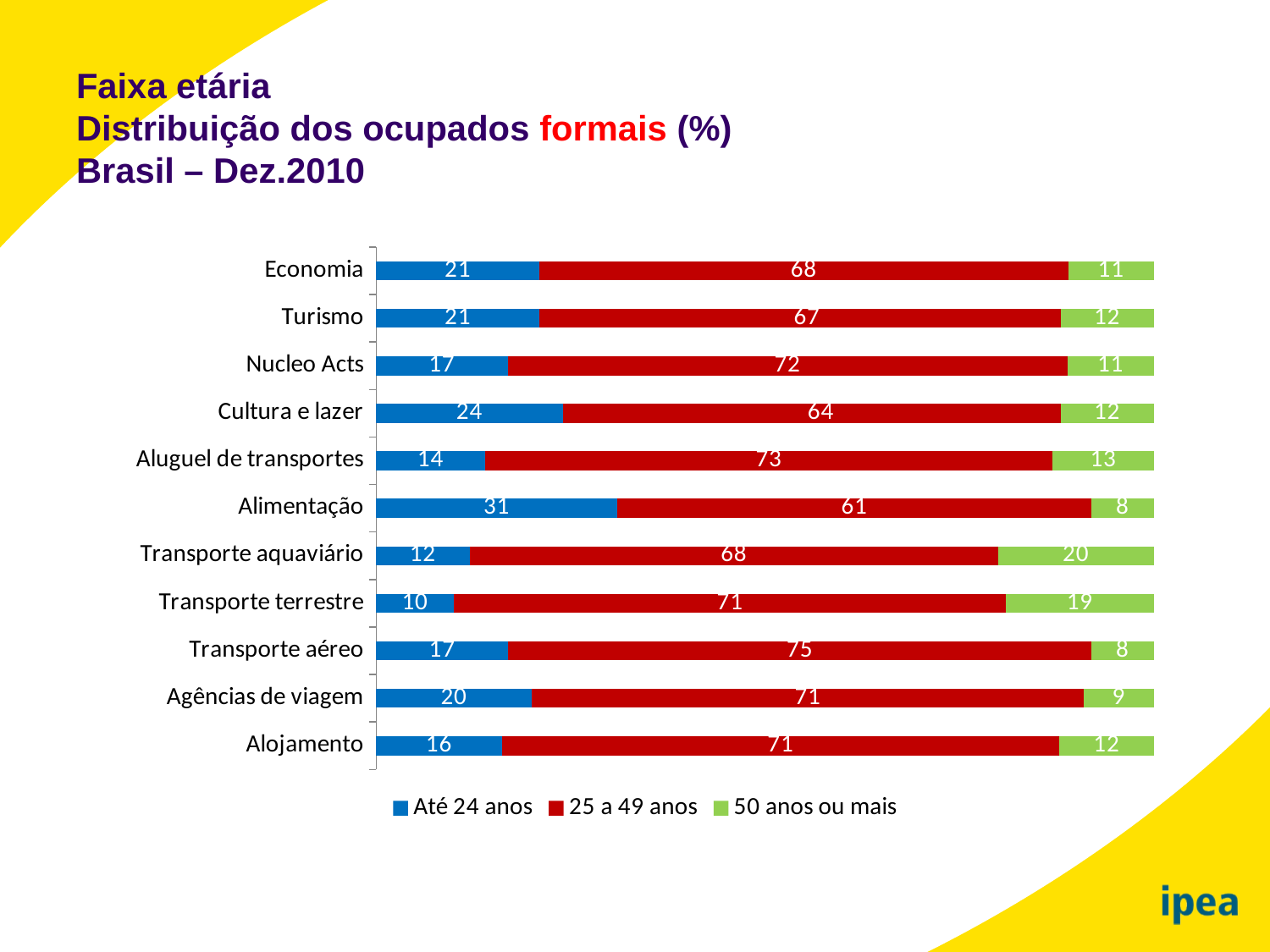
Which is larger: the 'Até 24 anos' value for Cultura e lazer or for Nucleo Acts? Cultura e lazer What is the value for '25 a 49 anos' in the Transporte aéreo category? 75 How many categories are shown on the chart? 11 How many series does the legend list? 3 Which category has the lowest value for 'Até 24 anos'? Transporte terrestre Which category has the highest value for 'Até 24 anos'? Alimentação What kind of chart is shown on the slide? Stacked bar chart Which category has the highest value for '50 anos ou mais'? Transporte aquaviário What is the value for '50 anos ou mais' in the Transporte aquaviário category? 20 What is the total of the stacked bar for Economia? 100 What is the difference between the '25 a 49 anos' values for Transporte aéreo and Alimentação? 14 What is the value for 'Até 24 anos' in the Alimentação category? 31